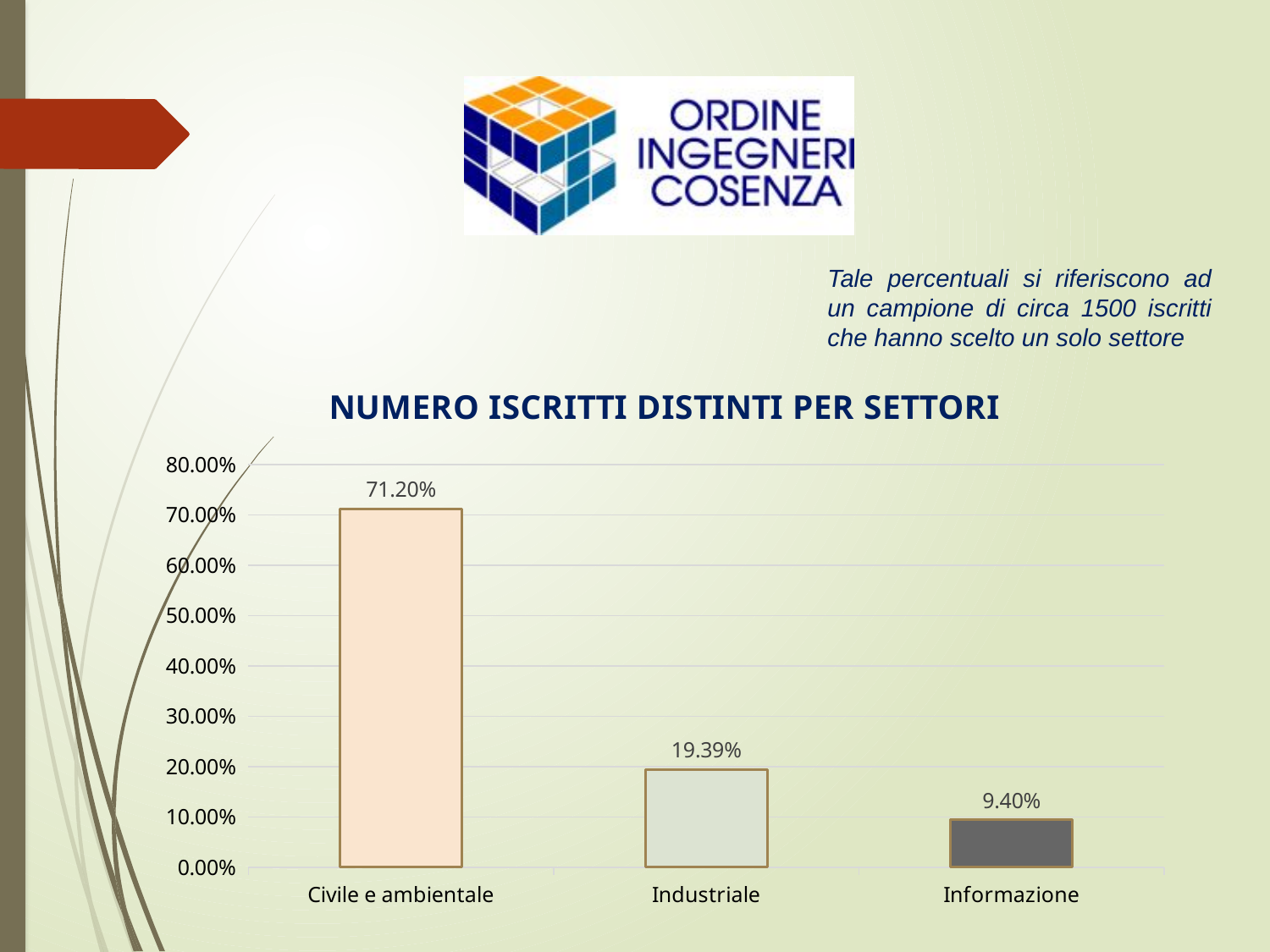
Which is larger, the value for Industriale or the value for Informazione? Industriale What is the value for Civile e ambientale? 71.20% Which sector has the highest value? Civile e ambientale Which sector has the lowest value? Informazione What is the difference between the values for Industriale and Informazione? 9.99% What is the value for Industriale? 19.39% What kind of chart is shown on the slide? bar chart How many sectors are shown on the chart? 3 What is the value for Informazione? 9.40% What is the difference between the values for Civile e ambientale and Industriale? 51.81% Is the value for Civile e ambientale greater or less than 70.00%? greater What is the title of the chart? NUMERO ISCRITTI DISTINTI PER SETTORI